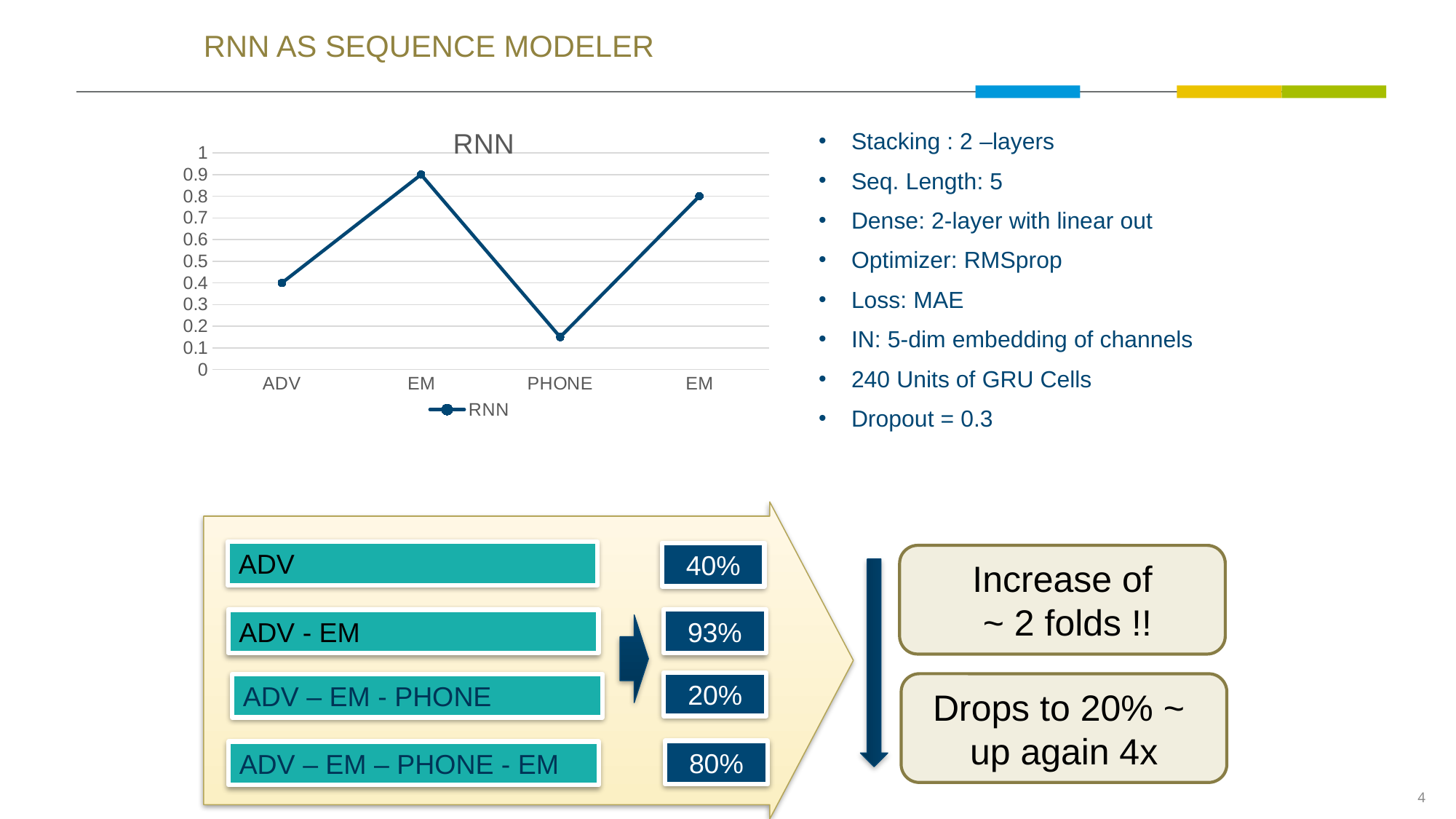
How many categories are plotted along the x axis of the RNN chart? 4 In the RNN chart, which is larger: the value for ADV or the value for the last EM (fourth category)? EM (fourth category) Which category has the highest value in the RNN chart? EM (the second category) Which category has the lowest value in the RNN chart? PHONE What is the value for ADV in the RNN chart? 0.4 What is the value for the last EM (fourth category) in the RNN chart? 0.8 What is the value for the first EM (second category) in the RNN chart? 0.9 In the RNN chart, does the line rise or fall from the first EM to PHONE? fall How many series does the legend of the RNN chart list? 1 What is the title of the line chart on the slide? RNN In the RNN chart, is the value for PHONE greater or less than 0.2? less What kind of chart is the RNN chart on the slide? line chart